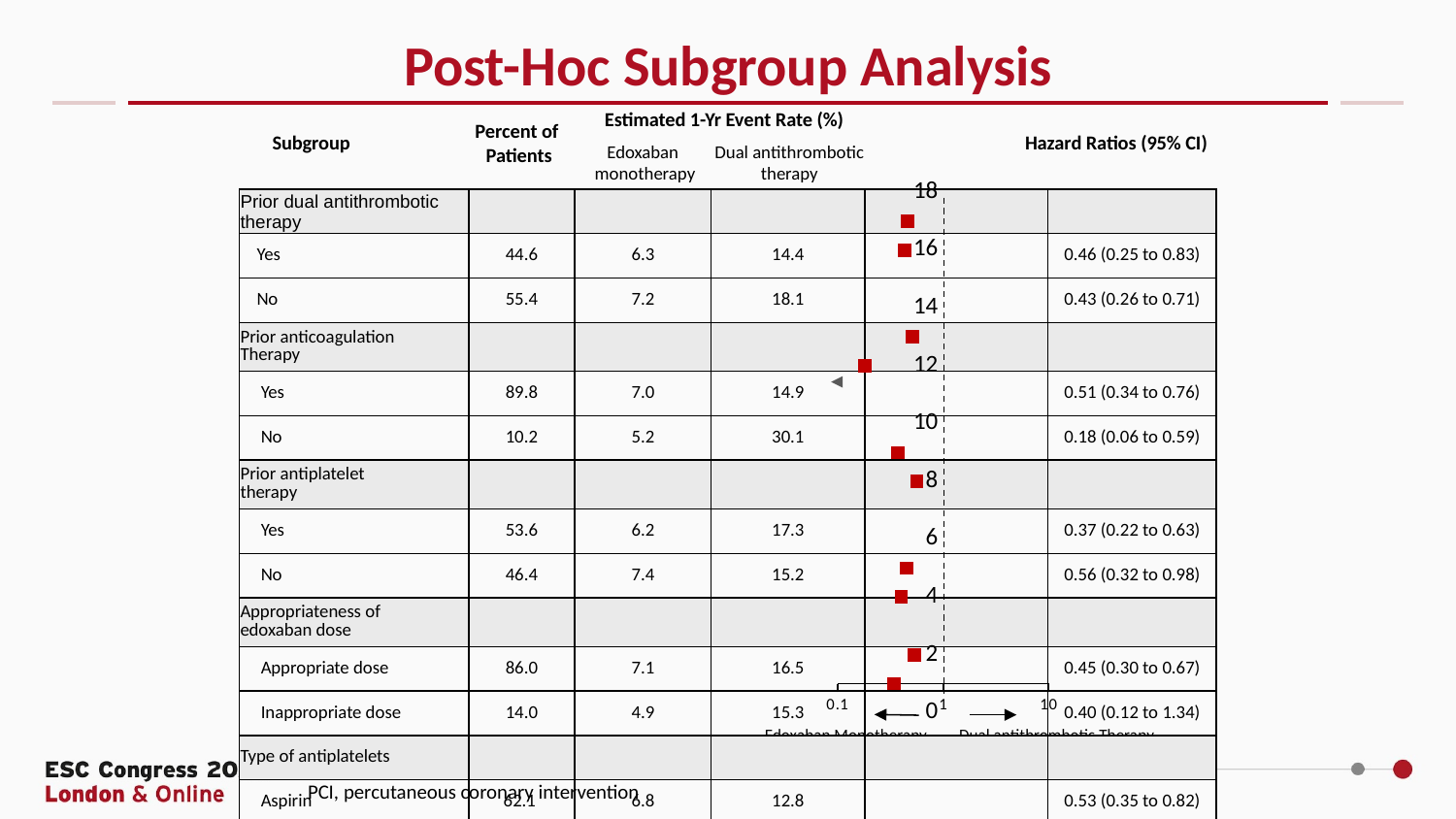
What kind of chart is shown on the slide? forest plot Is the plotted marker at the level of 8 on the vertical axis greater or less than 1 on the horizontal axis? less What is the highest value labeled on the vertical axis of the chart? 18 Is the topmost plotted marker on the chart greater or less than 1 on the horizontal axis? less What values are labeled on the horizontal axis of the chart? 0.1, 1, 10